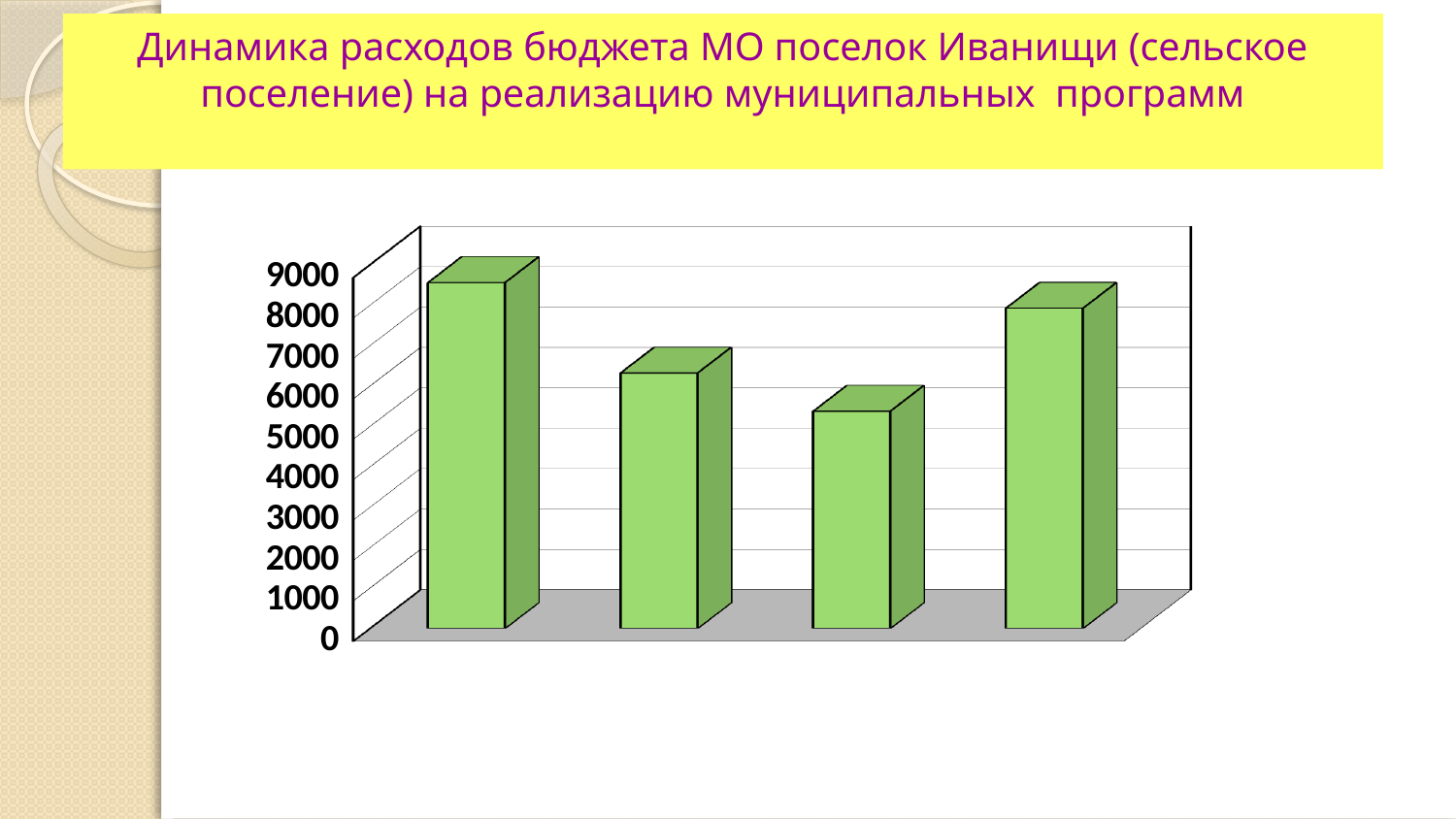
Which is taller, the second bar from the left or the third bar from the left? the second bar Is the value of the third bar from the left greater or less than 6000? less Which bar is the tallest in the chart? the first bar from the left Is the value of the fourth bar from the left greater or less than 7000? greater Is the value of the first bar from the left greater or less than 8000? greater Which is taller, the first bar from the left or the fourth bar from the left? the first bar What kind of chart is shown on the slide? bar chart Which bar is the shortest in the chart? the third bar from the left What is the highest value shown on the vertical axis? 9000 How many bars are plotted in the chart? 4